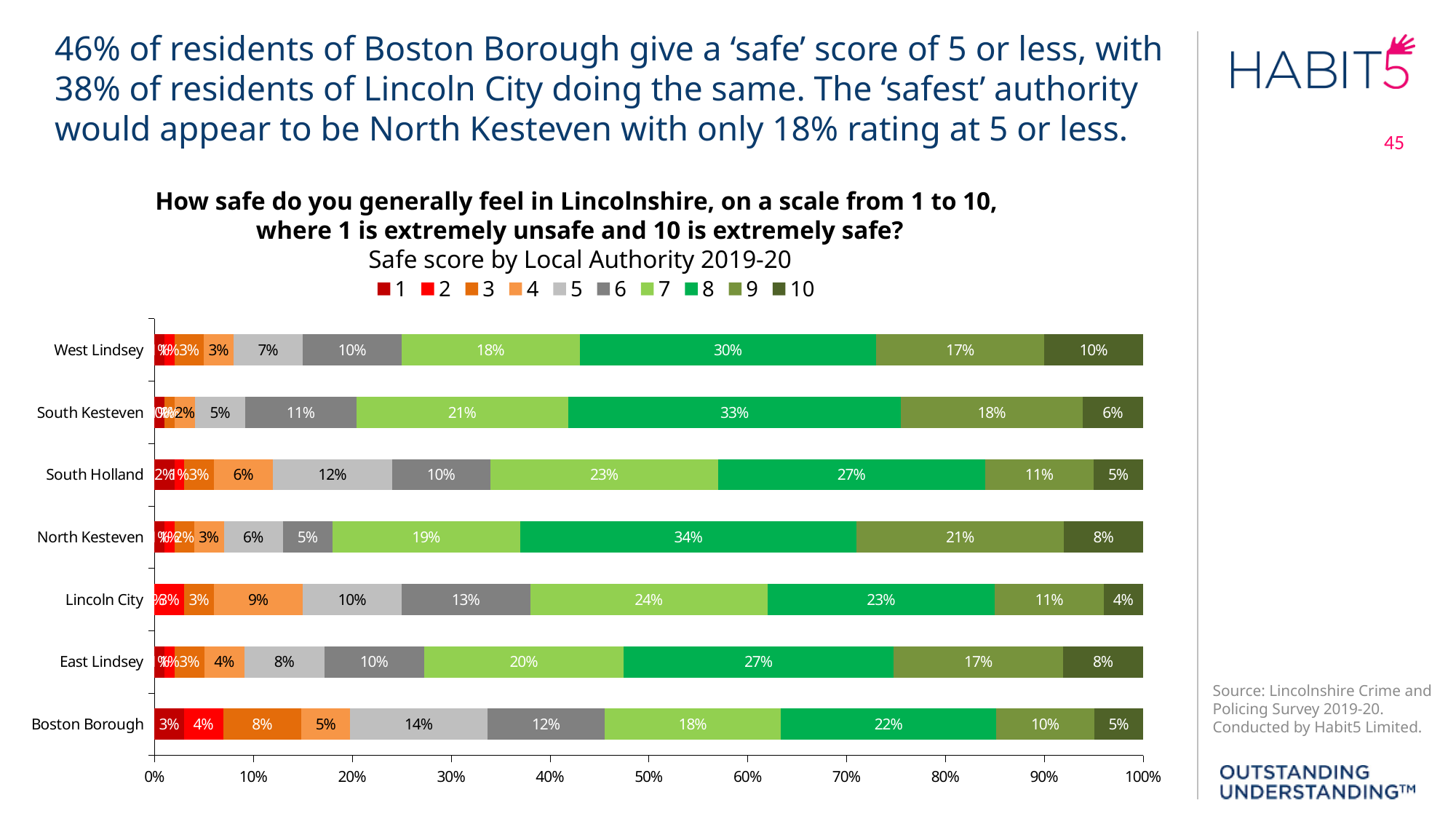
What is the difference between the share of residents giving a score of 7 in Lincoln City and in West Lindsey? 6% What percentage of South Kesteven residents gave a safe score of 6? 11% What percentage of North Kesteven residents gave a safe score of 9? 21% Which local authority has the highest share of residents giving a safe score of 8? North Kesteven Which local authority has the lowest share of residents giving a safe score of 10? Lincoln City How many series does the legend list? 10 How many local authorities are shown on the chart? 7 Which is larger: the share of residents giving a score of 5 in Boston Borough or in South Holland? Boston Borough What percentage of Boston Borough residents gave a safe score of 8? 22% What is the subtitle of the chart below the survey question? Safe score by Local Authority 2019-20 What percentage of Lincoln City residents gave a safe score of 4? 9% What kind of chart is shown on the slide? Stacked bar chart